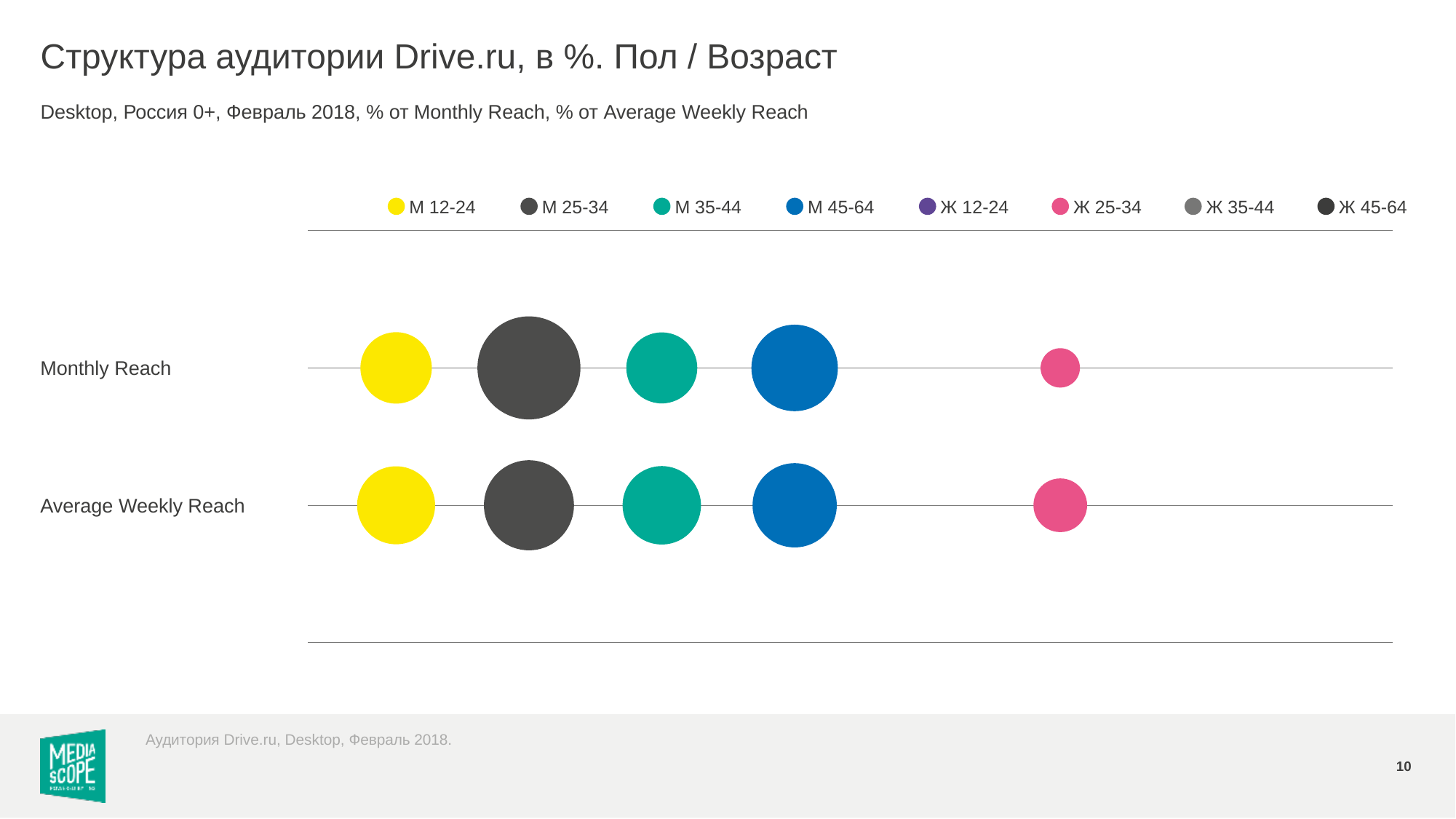
Which visible series has the smallest bubble in the Monthly Reach row? Ж 25-34 What is the title of the chart on the slide? Структура аудитории Drive.ru, в %. Пол / Возраст In the Average Weekly Reach row, which bubble is larger: М 45-64 or Ж 25-34? М 45-64 In the Monthly Reach row, which bubble is larger: М 25-34 or М 12-24? М 25-34 What kind of chart is shown on the slide? Bubble chart In the Monthly Reach row, which bubble is larger: М 25-34 or М 45-64? М 25-34 What colour is the bubble for the М 45-64 series? Blue How many series does the legend list? 8 How many rows (categories) are plotted on the chart? 2 Which series has the largest bubble in the Monthly Reach row? М 25-34